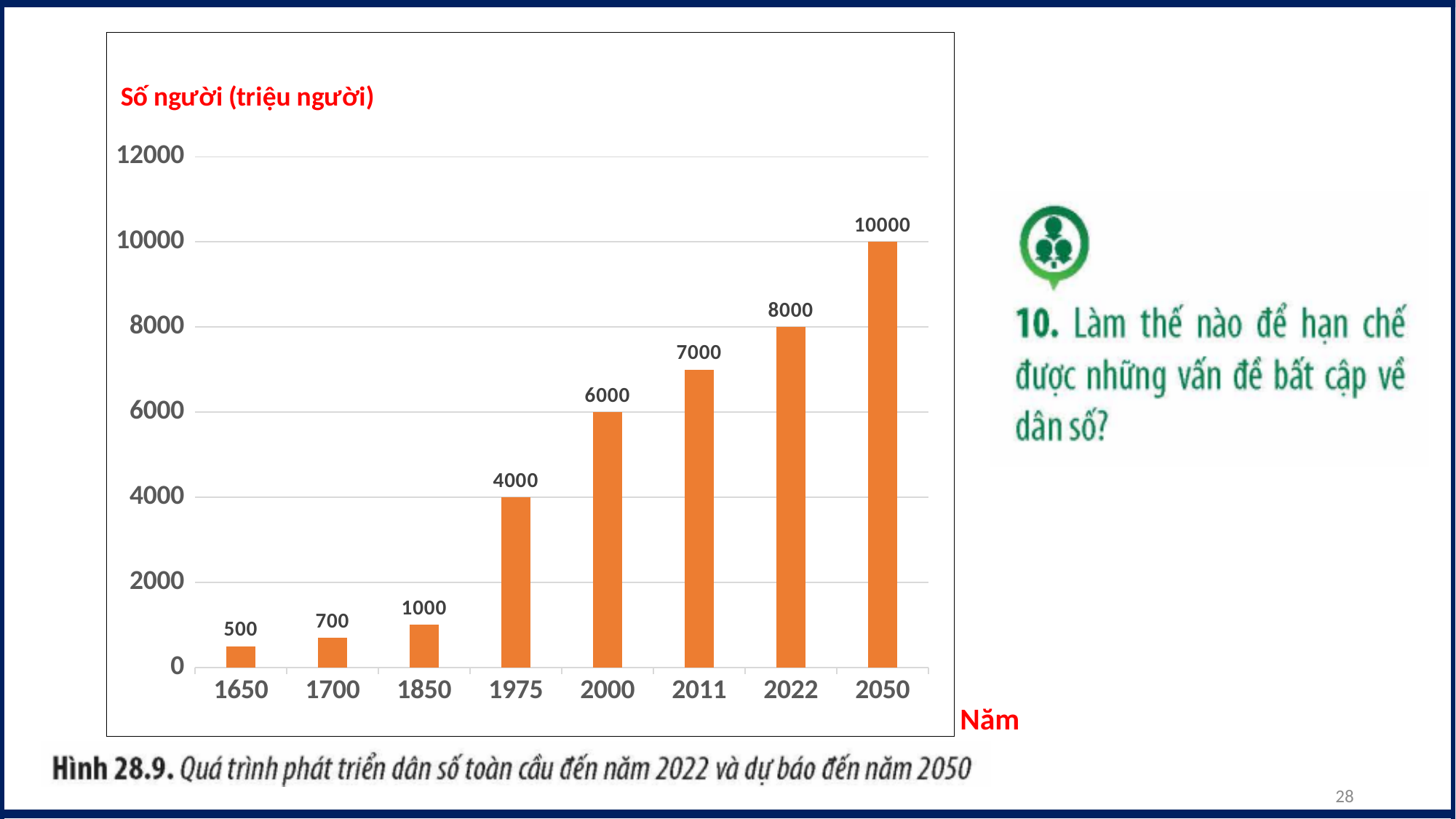
What is the difference between the values for 2050 and 2022? 2000 Which year has the lowest value? 1650 What is the value for the year 1650? 500 Do the values rise or fall from 1650 to 2050? rise What is the difference between the values for 1975 and 1850? 3000 What is the value for the year 2000? 6000 Is the value for 1700 greater or less than 2000? less What kind of chart is shown? bar chart Which year has the highest value? 2050 How many years are shown on the x axis? 8 Which is larger, the value for 2011 or the value for 2000? 2011 What is the value for the year 2022? 8000